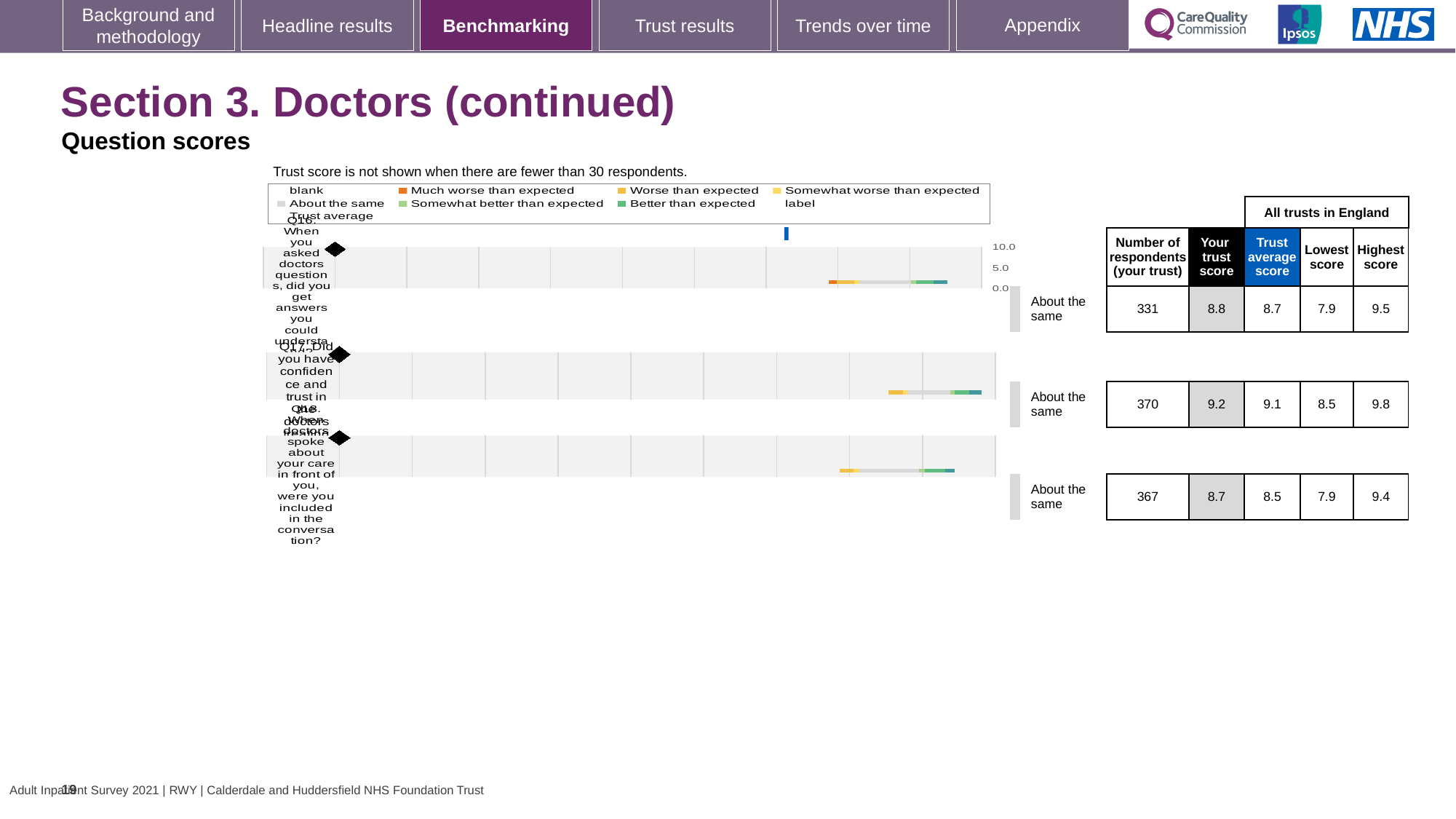
What kind of chart is used to show the question scores? Bar chart What is the lowest score across all trusts in England for Q17? 8.5 For Q17, which is larger: your trust score or the trust average score? Your trust score Which question has the lowest 'Your trust score'? Q18 How many respondents from your trust answered Q17? 370 What is the 'Your trust score' for Q16 (When you asked doctors questions, did you get answers you could understand)? 8.8 What is the trust average score for Q17 (Did you have confidence and trust in the doctors treating you)? 9.1 Which question has the highest 'Your trust score'? Q17 How many questions are plotted in the chart? 3 What benchmark category is shown for Q18? About the same What is the difference between your trust score and the trust average score for Q16? 0.1 What is the highest score across all trusts in England for Q18 (When doctors spoke about your care in front of you, were you included in the conversation)? 9.4